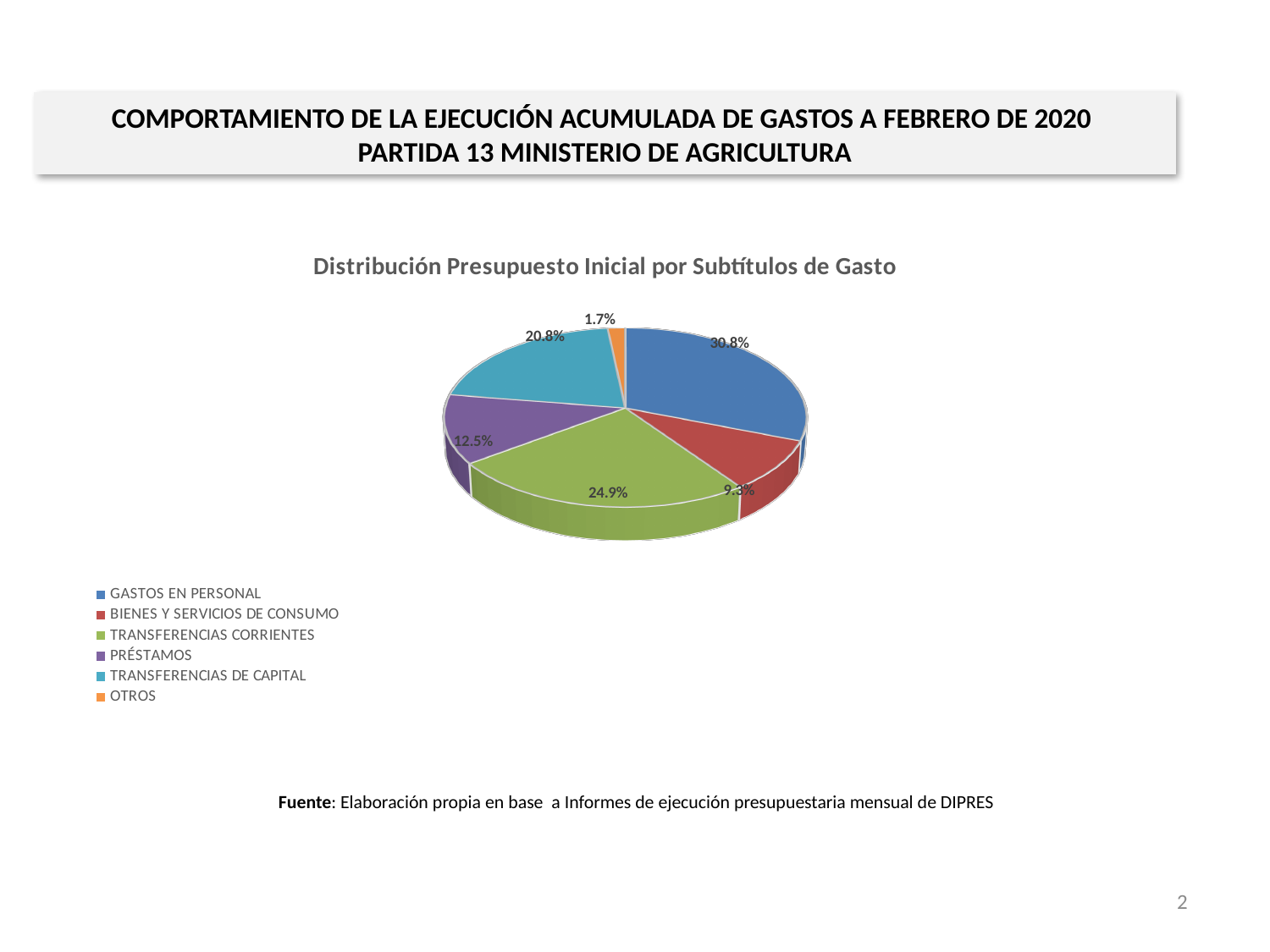
What is the title of the chart? Distribución Presupuesto Inicial por Subtítulos de Gasto What colour is the slice for TRANSFERENCIAS DE CAPITAL? Light blue (cyan) What share of the pie does GASTOS EN PERSONAL represent? 30.8% How many slices does the pie chart have? 6 Which category has the smallest share of the pie? OTROS What share of the pie does TRANSFERENCIAS CORRIENTES represent? 24.9% Which is larger, the share for BIENES Y SERVICIOS DE CONSUMO or the share for PRÉSTAMOS? PRÉSTAMOS What is the value shown for OTROS? 1.7% Which category has the largest share of the pie? GASTOS EN PERSONAL What is the value shown for PRÉSTAMOS? 12.5% What is the difference between the shares of GASTOS EN PERSONAL and TRANSFERENCIAS DE CAPITAL? 10.0% What kind of chart is shown on the slide? Pie chart